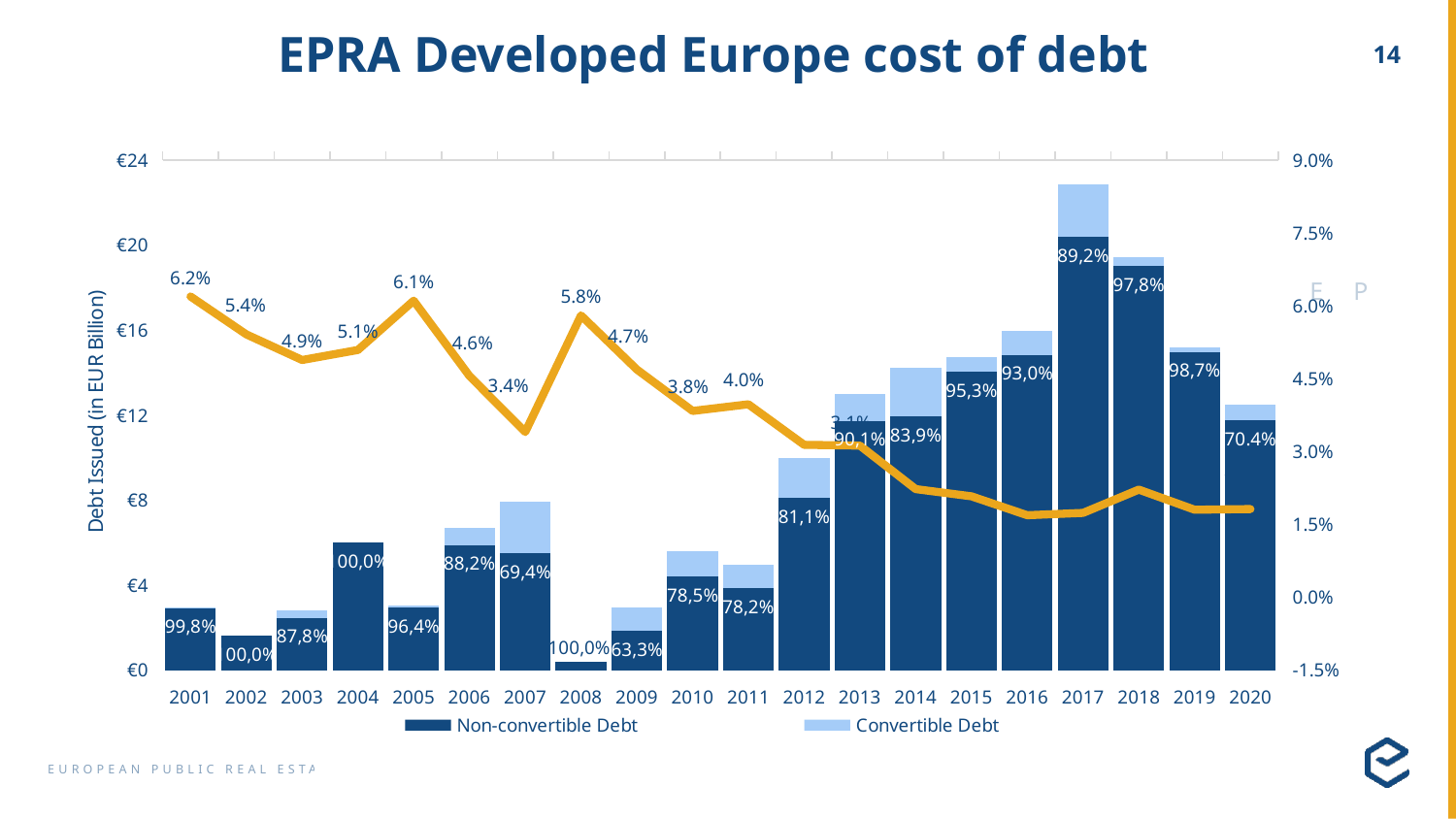
Is the total debt issued in 2017 greater or less than €20 billion? greater Is the cost of debt line value for 2016 greater or less than 3.0%? less How many series does the legend list? 2 Which year has a higher cost of debt, 2008 or 2009? 2008 What percentage label is shown on the 2018 bar? 97,8% In which year does the cost of debt line reach its highest value? 2001 What is the cost of debt value shown on the line for 2001? 6.2% What is the cost of debt value shown on the line for 2007? 3.4% What is the cost of debt value shown on the line for 2005? 6.1% Which year has the smallest total debt issued bar? 2008 What is the difference between the cost of debt in 2001 and in 2002? 0.8 percentage points How many years are shown on the x axis? 20